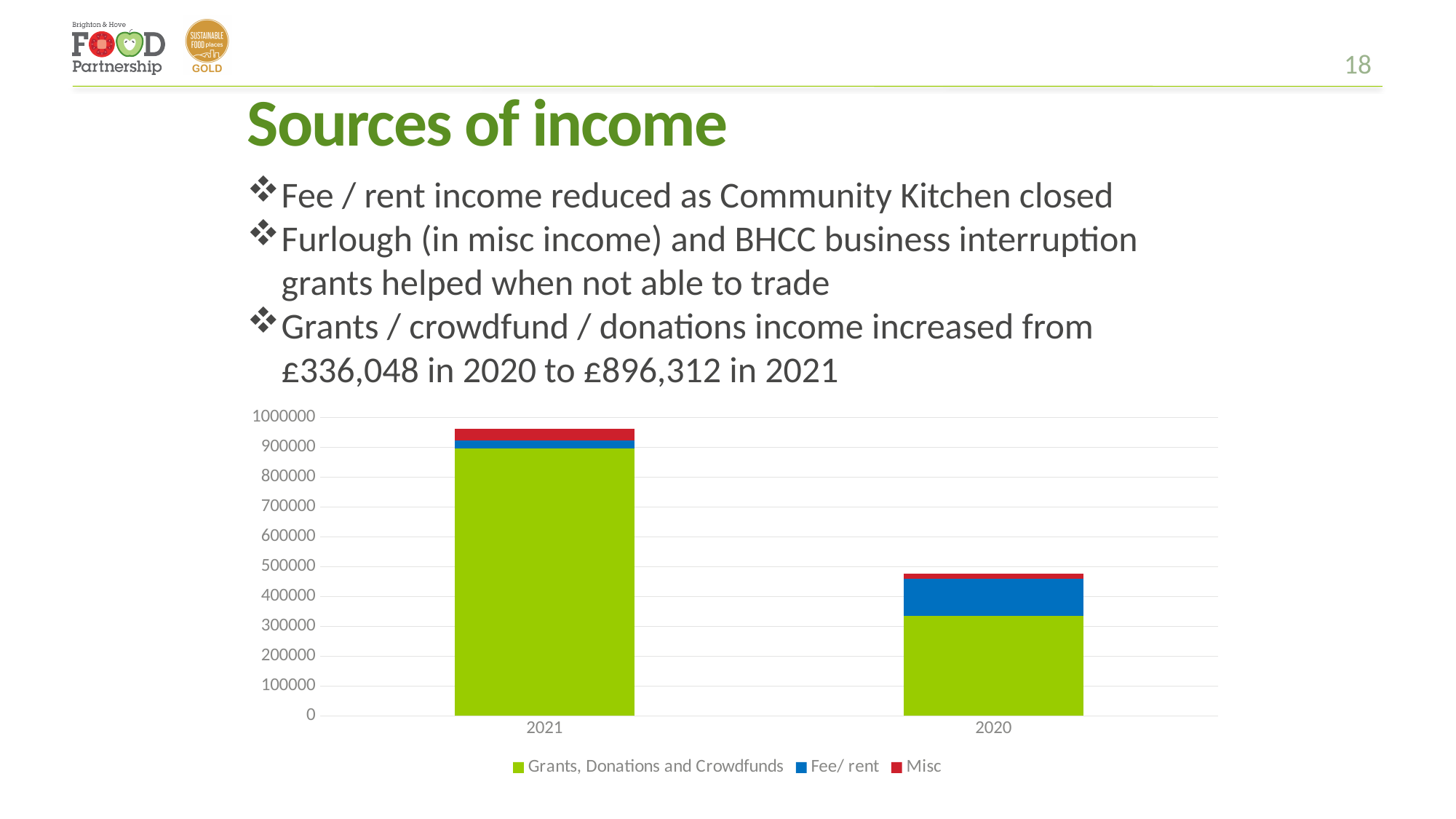
Which year has the larger Fee/ rent segment, 2021 or 2020? 2020 How many series does the chart legend list? 3 Is the total income bar for 2020 greater or less than 500000? less Is the Grants, Donations and Crowdfunds segment for 2020 greater or less than 400000? less Is the total income bar for 2021 greater or less than 900000? greater Which colour represents Misc in the chart legend? Red By how much did Grants / crowdfund / donations income increase from 2020 to 2021, according to the figures on the slide? £560,264 What kind of chart is shown on the slide? Stacked bar chart According to the slide, what was the Grants / crowdfund / donations income in 2021? £896,312 How many years (categories) are shown on the x axis of the chart? 2 Which year has the taller total income bar, 2021 or 2020? 2021 Which year has the smaller total income bar? 2020